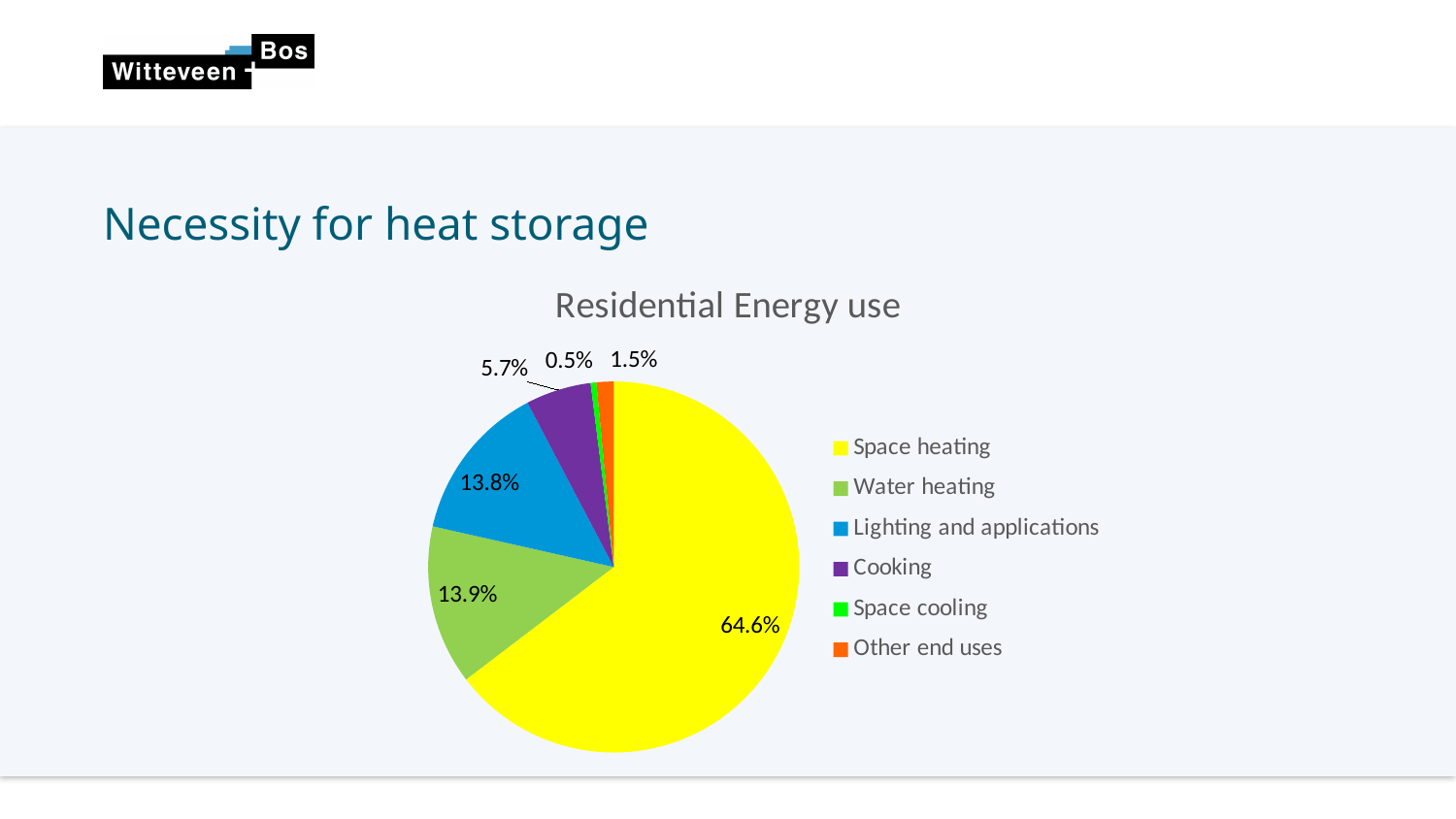
Which category has the smallest share of residential energy use? Space cooling What share of residential energy use is Cooking? 5.7% What is the difference in percentage points between Space heating and Cooking? 58.9 What share of residential energy use is Other end uses? 1.5% What share of residential energy use is Lighting and applications? 13.8% Which category has the largest share of residential energy use? Space heating What share of residential energy use is Water heating? 13.9% What type of chart is shown on the slide? Pie chart What share of residential energy use is Space heating? 64.6% What is the title of the chart? Residential Energy use How many categories does the legend list? 6 What share of residential energy use is Space cooling? 0.5%